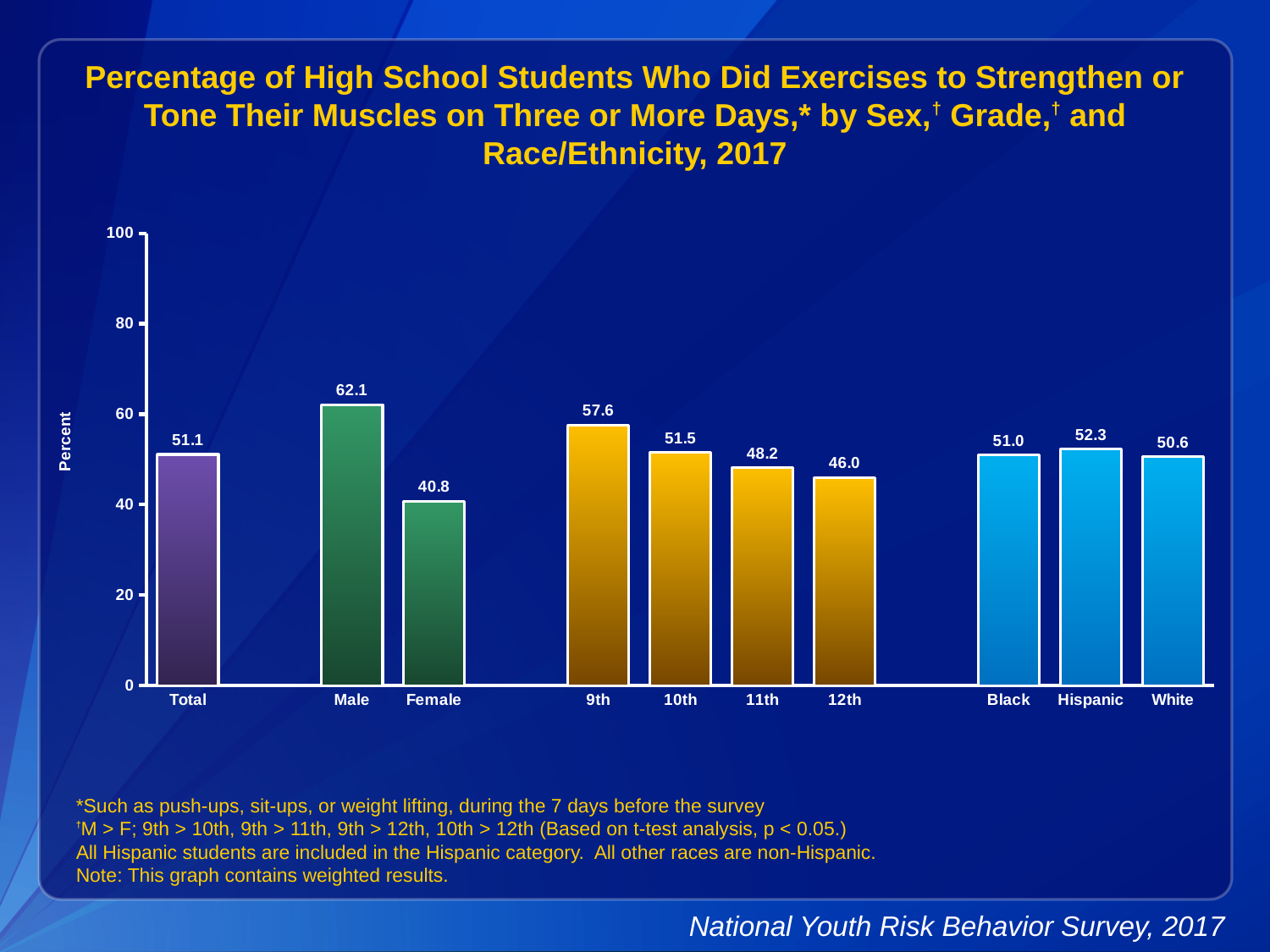
Do the values rise or fall from 9th grade to 12th grade? Fall What is the value for Total? 51.1 What is the difference between the Male and Female values? 21.3 What is the value for Hispanic? 52.3 What is the value for 12th grade? 46.0 What is the value for Female? 40.8 Which category has the lowest value? Female How many bars are shown in the chart? 10 Which category has the highest value? Male Which is larger, the value for Black or the value for White? Black What is the difference between the 9th grade and 12th grade values? 11.6 What kind of chart is shown on the slide? Bar chart